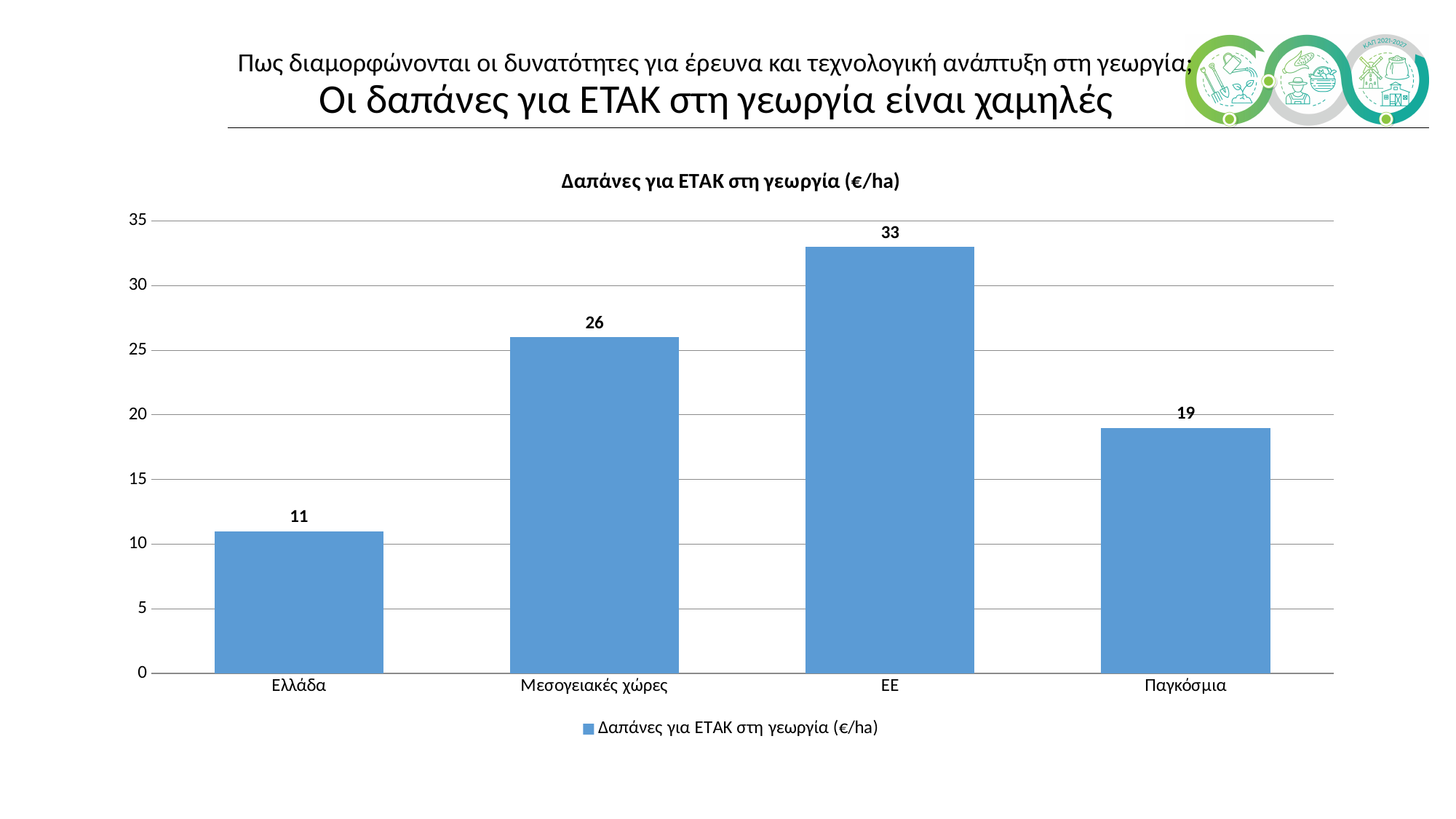
What is the value for ΕΕ? 33 What kind of chart is shown on the slide? bar chart What is the value for Παγκόσμια? 19 Which category has the lowest value? Ελλάδα What is the difference between the values for ΕΕ and Ελλάδα? 22 Which is larger, the value for Μεσογειακές χώρες or the value for Παγκόσμια? Μεσογειακές χώρες What is the title of the chart? Δαπάνες για ΕΤΑΚ στη γεωργία (€/ha) Which category has the highest value? ΕΕ What is the value for Μεσογειακές χώρες? 26 How many categories are shown on the x axis? 4 What is the value for Ελλάδα? 11 Is the value for Παγκόσμια greater or less than 20? less